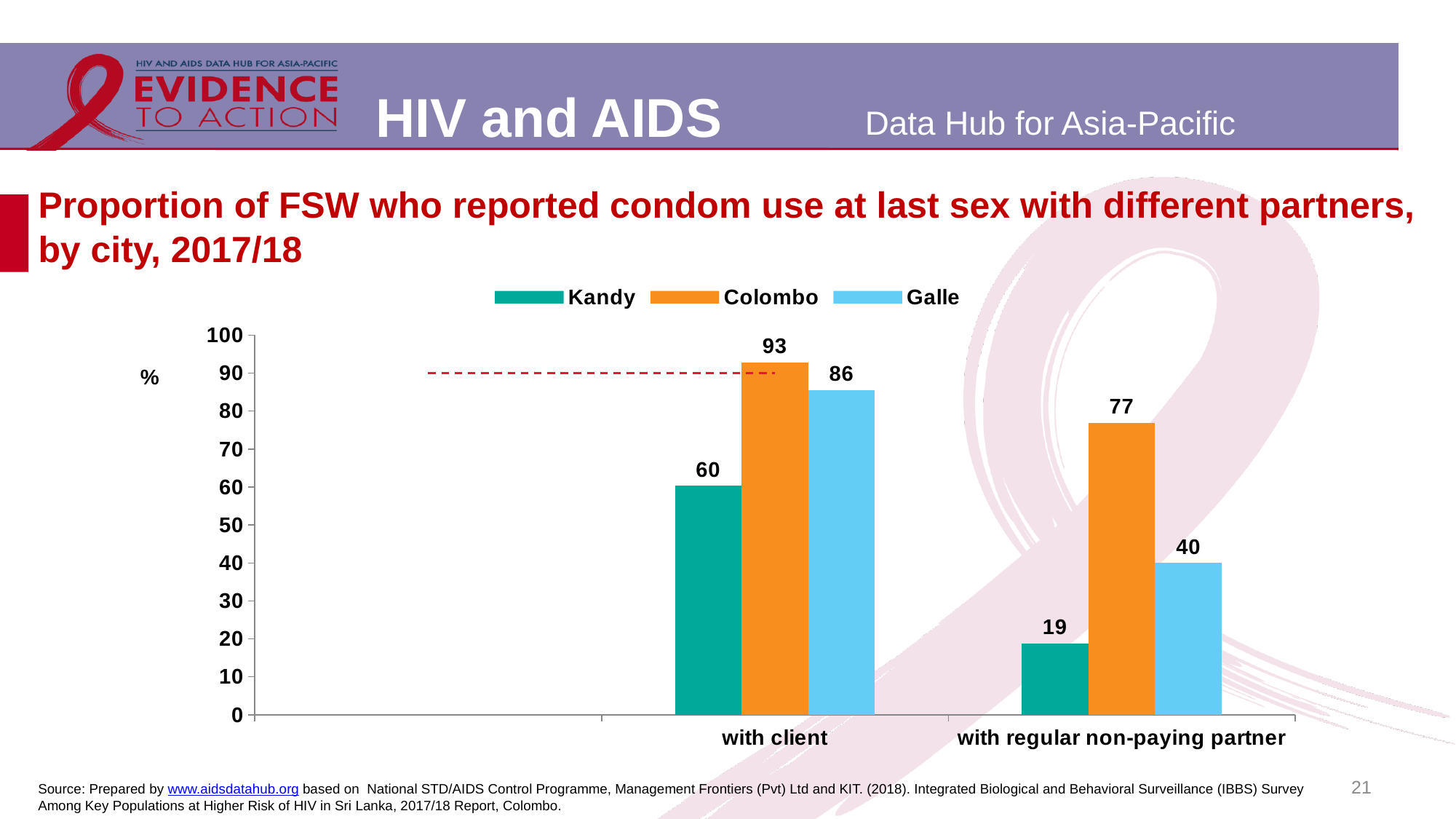
How many partner categories are shown on the x axis? 2 What is the value for Kandy in the 'with regular non-paying partner' category? 19 Which city is represented by the orange bars in the legend? Colombo How many series does the legend list? 3 Which is larger: Galle's value 'with client' or Colombo's value 'with regular non-paying partner'? Galle's value with client What is the difference between Galle's 'with client' value and its 'with regular non-paying partner' value? 46 What is the value for Colombo in the 'with client' category? 93 What kind of chart is shown on the slide? Bar chart What is the value for Galle in the 'with client' category? 86 Which city has the highest value in the 'with regular non-paying partner' category? Colombo What is the difference between the Colombo and Kandy values in the 'with client' category? 33 Which city has the lowest value in the 'with client' category? Kandy